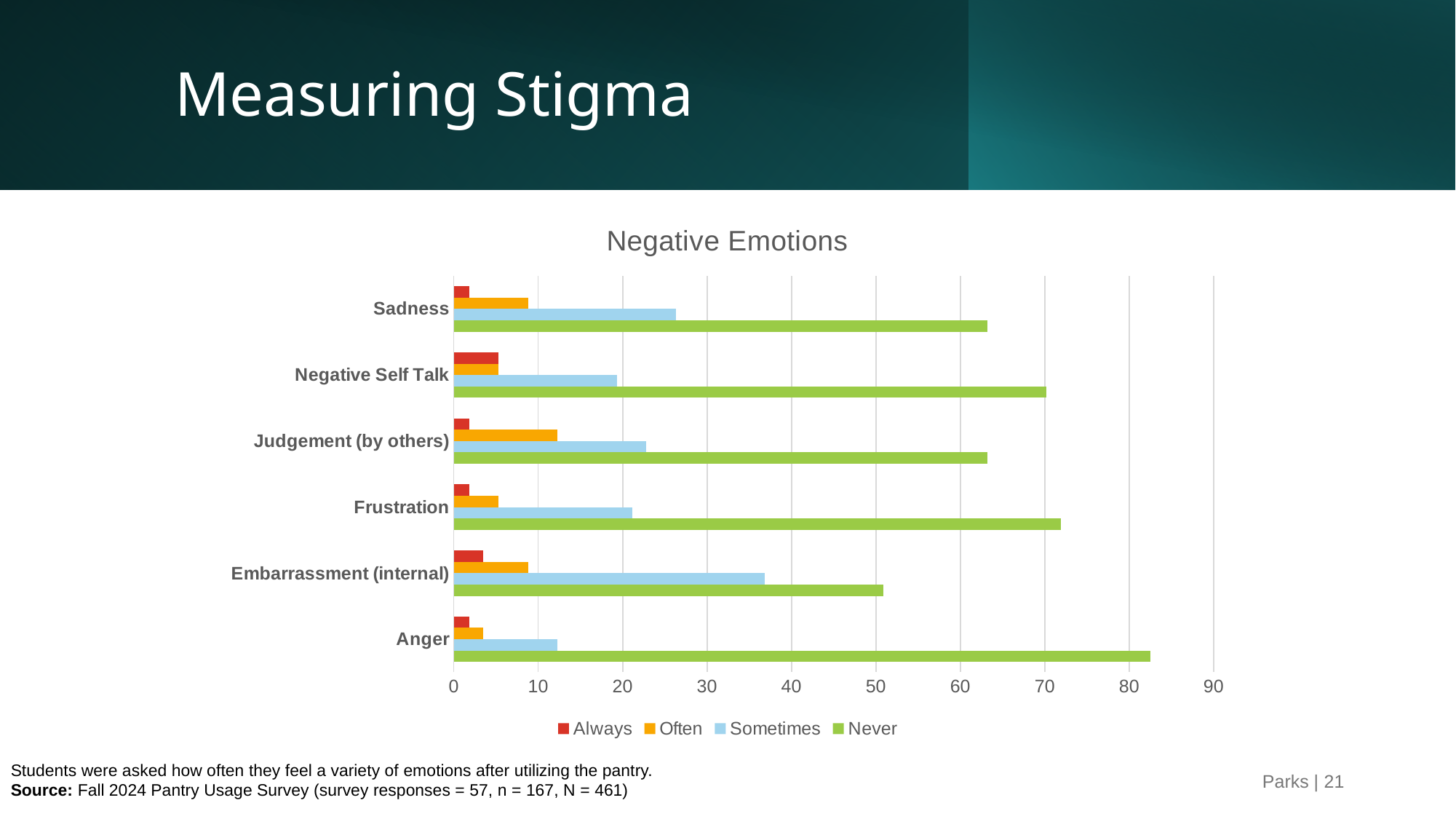
Which is larger: the 'Sometimes' value for Embarrassment (internal) or the 'Sometimes' value for Anger? Embarrassment (internal) What is the title of the chart? Negative Emotions Which emotion has the highest 'Never' value? Anger Which emotion has the highest 'Sometimes' value? Embarrassment (internal) Which emotion has the lowest 'Never' value? Embarrassment (internal) Is the 'Never' value for Anger greater or less than 80? greater How many series does the legend list? 4 How many emotion categories are shown on the chart? 6 Which colour represents the 'Never' series? green Which emotion has the highest 'Often' value? Judgement (by others) What kind of chart is shown on the slide? bar chart Is the 'Never' value for Embarrassment (internal) greater or less than 60? less